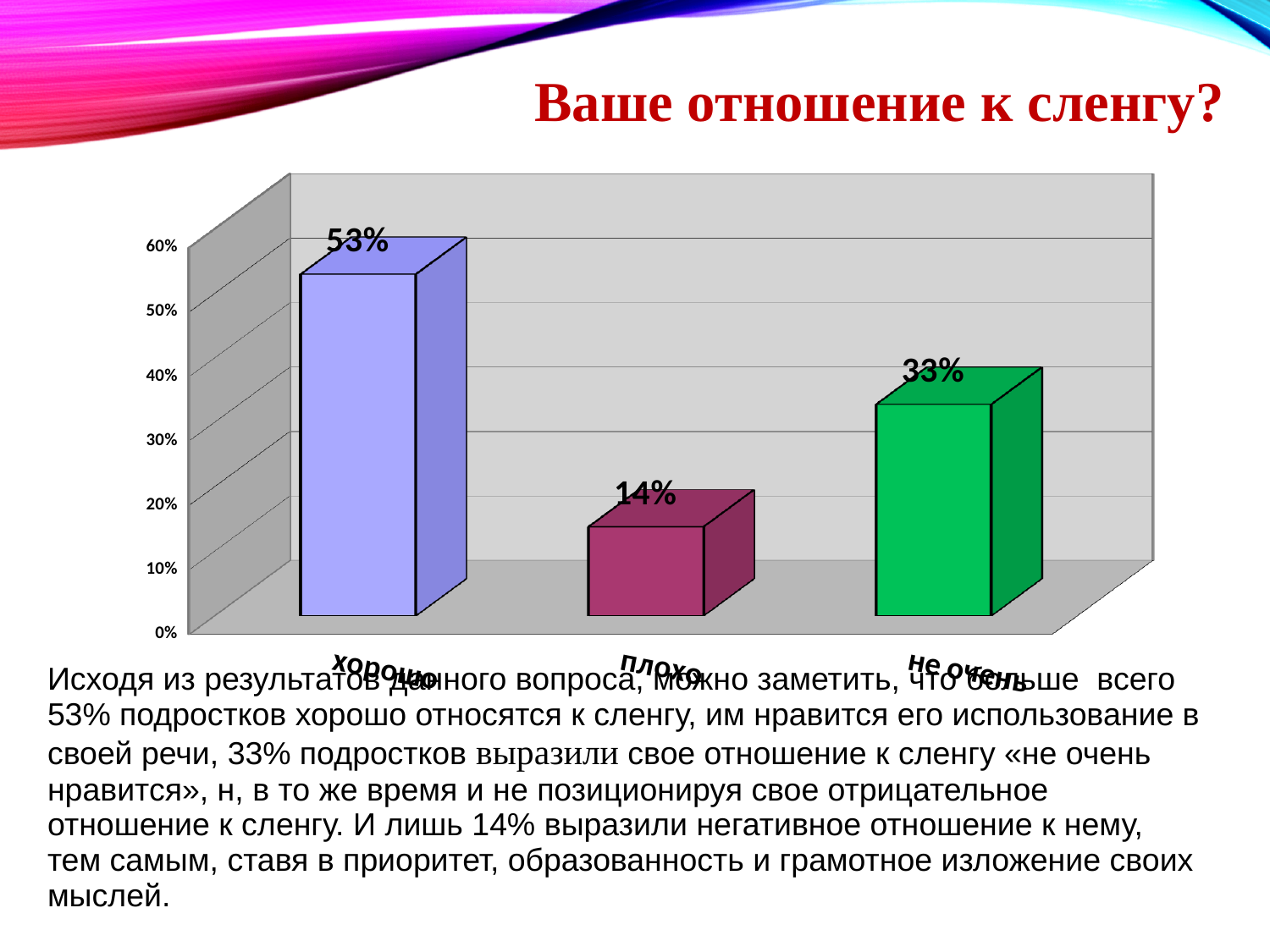
Which category has the highest value? хорошо What is the title of the slide above the chart? Ваше отношение к сленгу? What value is shown for the category "хорошо"? 53% What type of chart is shown on the slide? bar chart What value is shown for the category "плохо"? 14% What is the difference between the values for "не очень" and "плохо"? 19% How many categories are shown in the chart? 3 Is the value for "хорошо" greater or less than 50%? greater What is the difference between the values for "хорошо" and "не очень"? 20% What value is shown for the category "не очень"? 33% Which category has the lowest value? плохо Which is larger, the value for "не очень" or the value for "плохо"? не очень